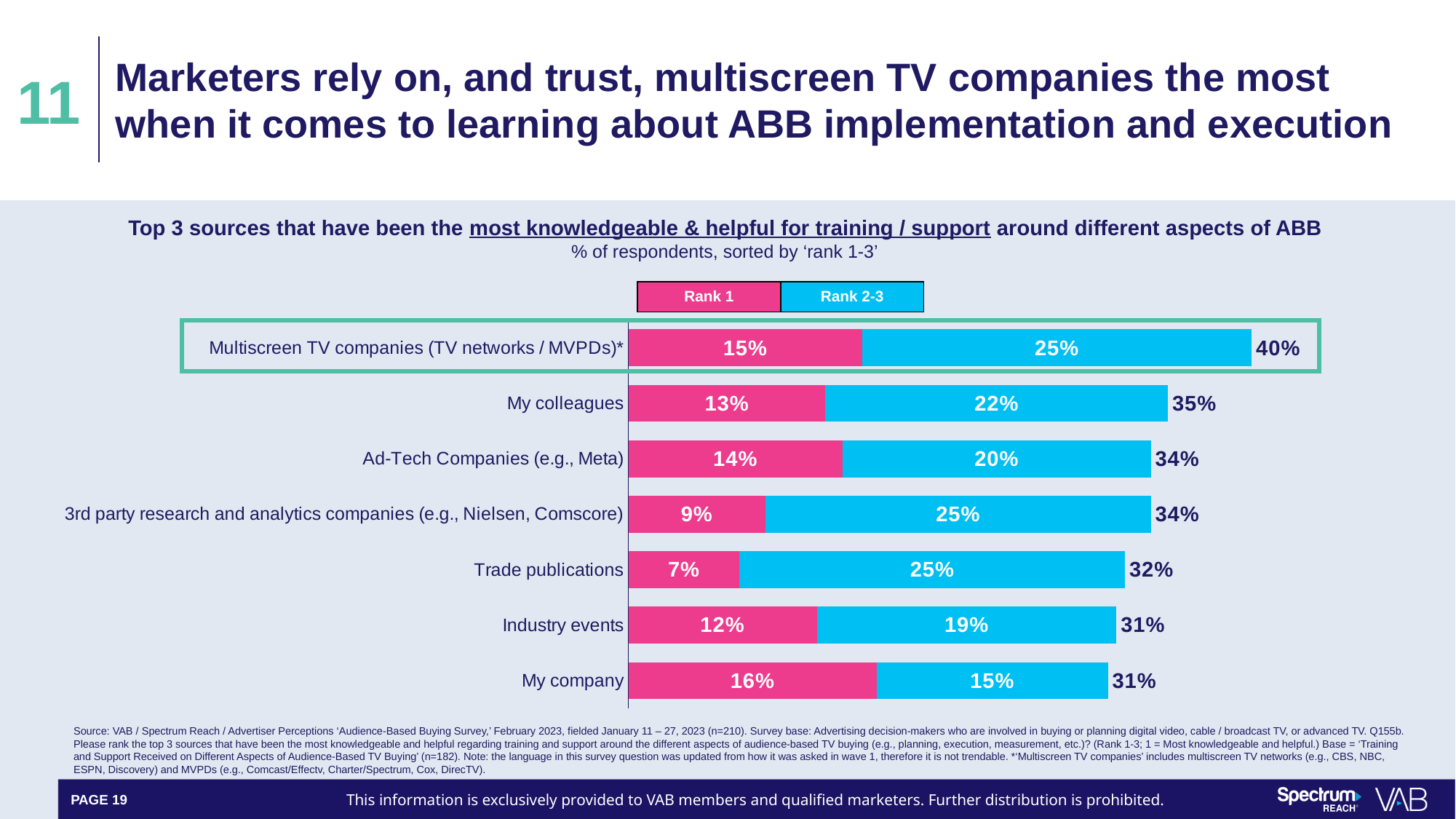
What is the Rank 2-3 value for Trade publications? 25% What is the difference between the Rank 2-3 values for Ad-Tech Companies (e.g., Meta) and Industry events? 1% Which source has the lowest Rank 1 value? Trade publications Which is larger: the Rank 1 value for My company or the Rank 1 value for Industry events? My company What is the total (rank 1-3) for My colleagues? 35% Which colour represents Rank 1 in the legend? Pink What is the Rank 1 value for Multiscreen TV companies (TV networks / MVPDs)? 15% Which source has the highest total (rank 1-3) share? Multiscreen TV companies (TV networks / MVPDs)* How many series does the legend list? 2 What is the Rank 1 value for My company? 16% What kind of chart is shown on the slide? Stacked bar chart How many sources are shown in the chart? 7